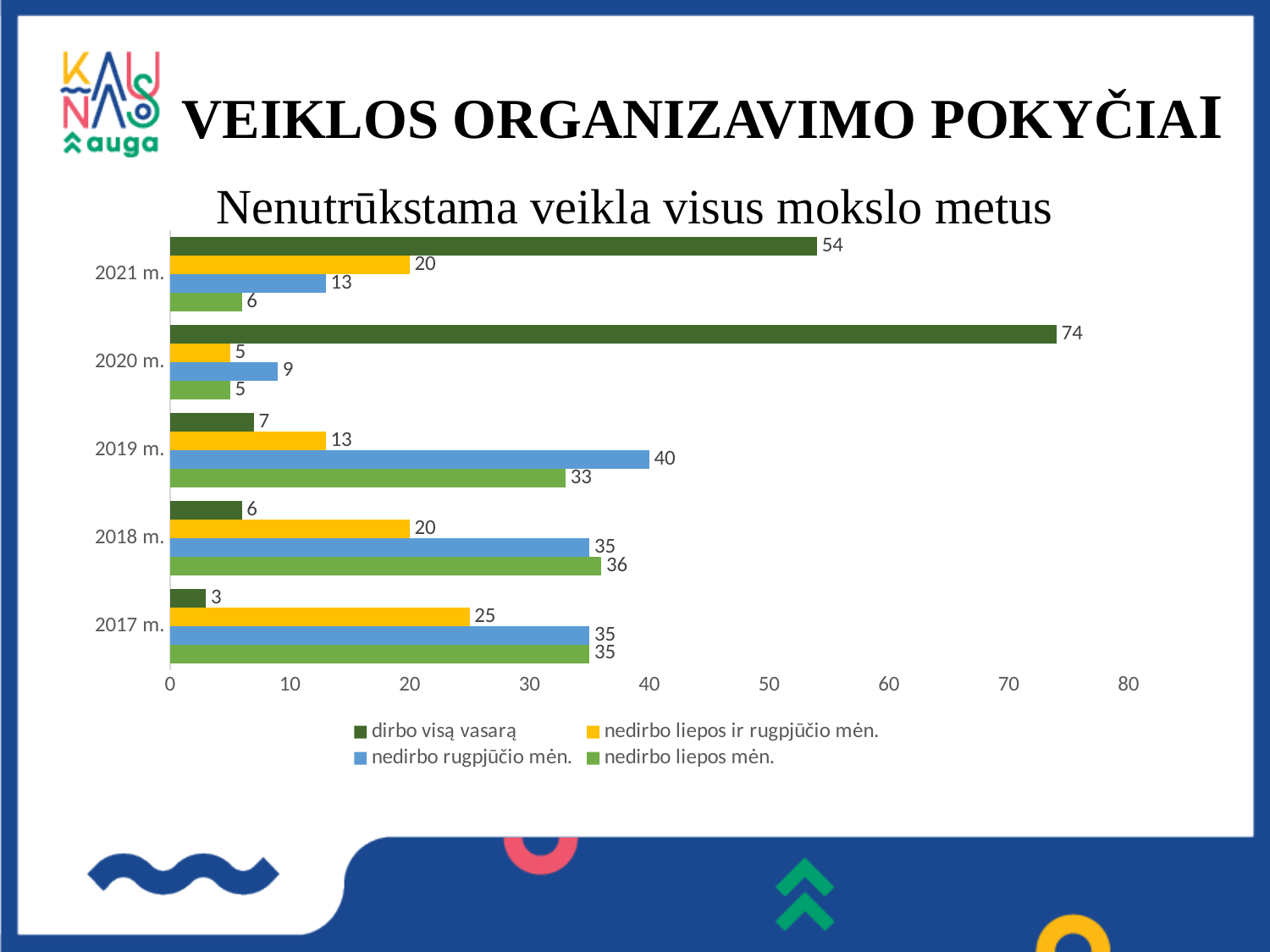
How many series does the legend list? 4 Which is larger in 2019 m.: "nedirbo rugpjūčio mėn." or "nedirbo liepos mėn."? nedirbo rugpjūčio mėn. In which year is the value for "dirbo visą vasarą" lowest? 2017 m. What kind of chart is shown on the slide? bar chart Is the value for "dirbo visą vasarą" in 2021 m. greater or less than 50? greater What is the value for "nedirbo liepos ir rugpjūčio mėn." in 2017 m.? 25 In which year is the value for "dirbo visą vasarą" highest? 2020 m. What is the value for "nedirbo liepos mėn." in 2021 m.? 6 What is the value for "dirbo visą vasarą" in 2020 m.? 74 What is the value for "nedirbo rugpjūčio mėn." in 2019 m.? 40 How many years are shown on the chart? 5 What is the difference between the "dirbo visą vasarą" values for 2020 m. and 2021 m.? 20